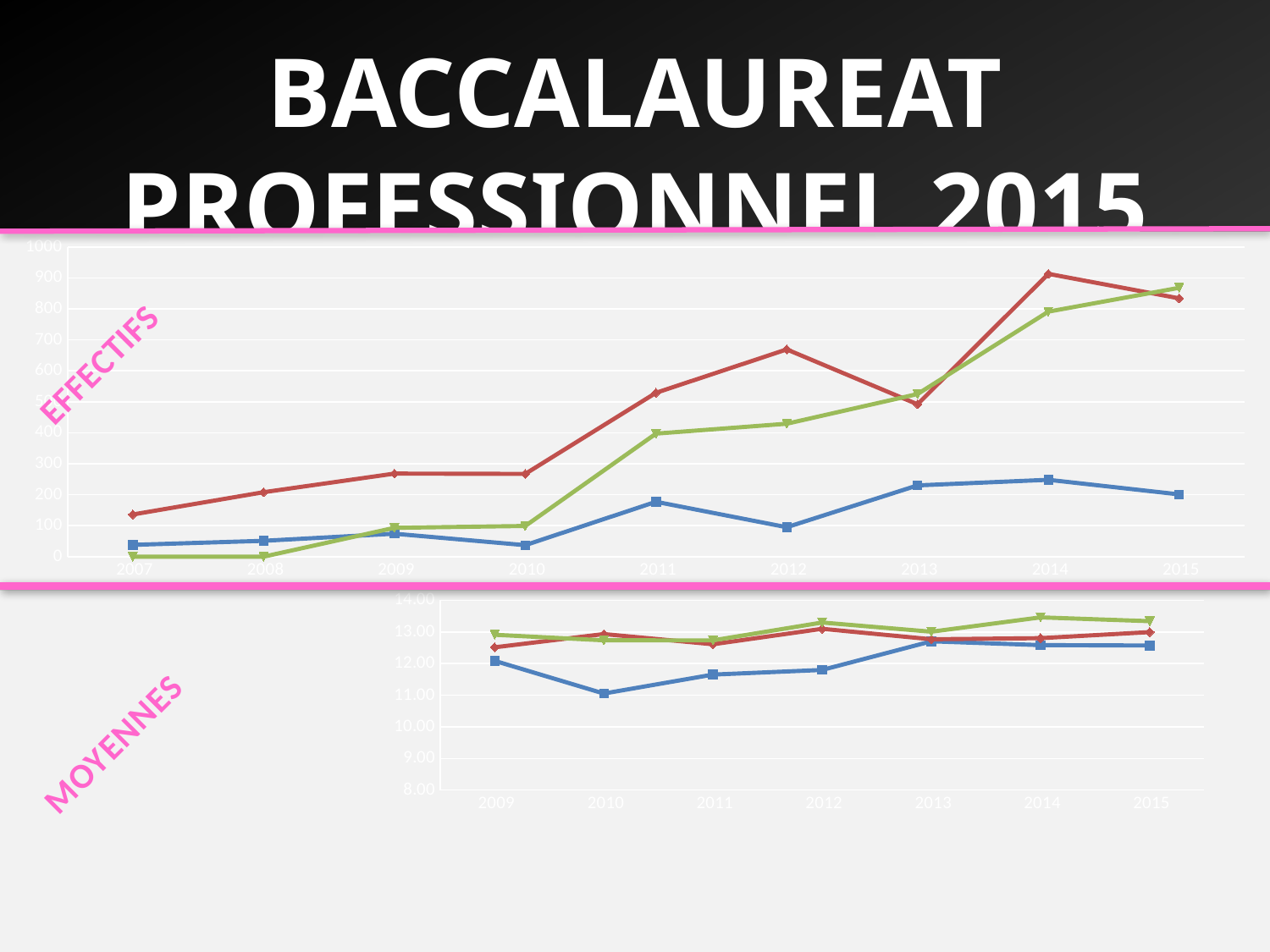
In the bottom chart (MOYENNES), in which year does the blue line reach its lowest value? 2010 In the bottom chart (MOYENNES), does the blue line rise or fall from 2009 to 2010? fall In the top chart (EFFECTIFS), in 2014, which line is higher, the red line or the green line? red line What kind of chart is the top chart labelled EFFECTIFS? line chart In the top chart (EFFECTIFS), in which year does the red line reach its highest value? 2014 How many years are shown on the x axis of the top chart (EFFECTIFS)? 9 In the top chart (EFFECTIFS), is the value of the red line in 2012 greater or less than 600? greater In the bottom chart (MOYENNES), is the value of the blue line in 2011 greater or less than 12.00? less How many lines are plotted in the top chart (EFFECTIFS)? 3 In the top chart (EFFECTIFS), is the value of the green line in 2007 greater or less than 100? less How many years are shown on the x axis of the bottom chart (MOYENNES)? 7